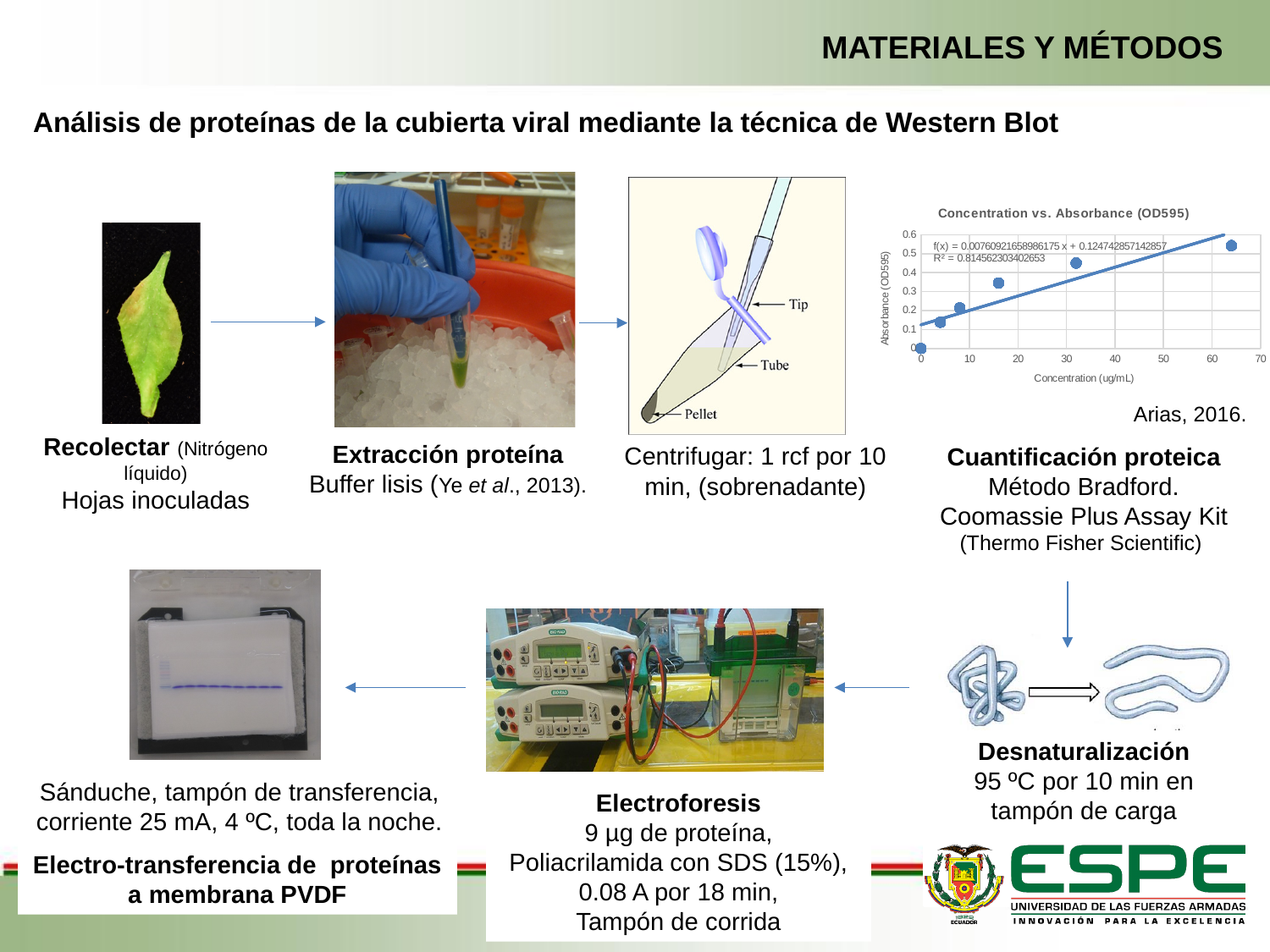
Is the absorbance of the point at 0 ug/mL greater or less than 0.1? less Does absorbance rise or fall as concentration increases along the x axis? rise How many data points are plotted in the chart? 6 What kind of chart is shown on the slide? scatter chart Is the absorbance of the point at the highest concentration (around 64 ug/mL) greater or less than 0.5? greater Is the absorbance of the point at about 4 ug/mL greater or less than 0.2? less Which has the higher absorbance: the point at about 8 ug/mL or the point at about 32 ug/mL? the point at about 32 ug/mL What is the highest tick value shown on the y axis of the chart? 0.6 What is the title of the chart on the slide? Concentration vs. Absorbance (OD595) What is the label of the x axis of the chart? Concentration (ug/mL)